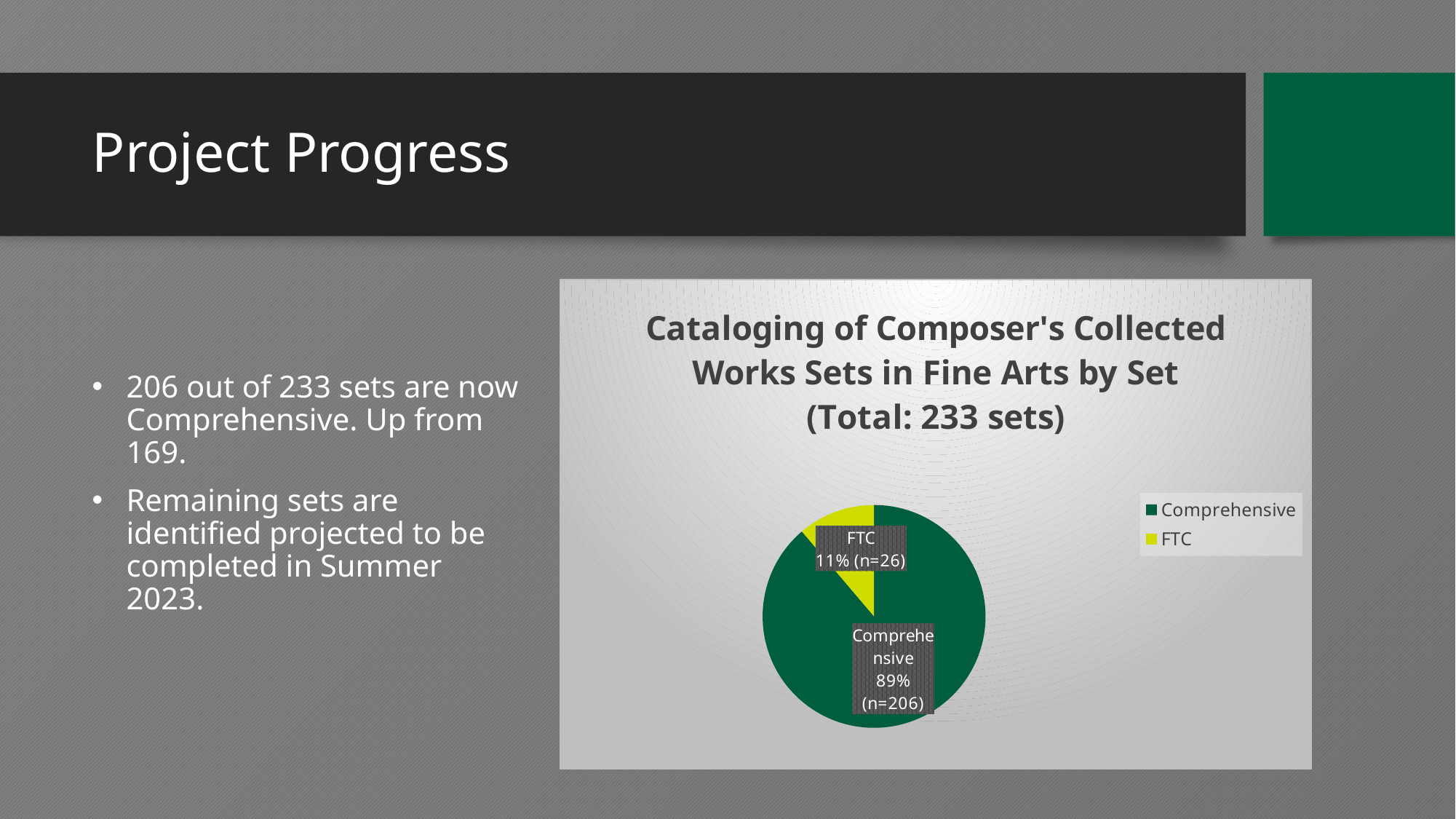
Which category has the smallest slice of the pie? FTC How many categories does the pie chart have? 2 What is the difference in number of sets between Comprehensive and FTC? 180 What colour is the FTC slice in the pie chart? Yellow-green How many sets are in the FTC category according to the data label? 26 What percentage of the pie does the FTC slice represent? 11% What is the total number of sets stated in the chart title? 233 sets Which category has the largest slice of the pie? Comprehensive What kind of chart is shown on the slide? Pie chart How many sets are in the Comprehensive category according to the data label? 206 Which is larger, the Comprehensive slice or the FTC slice? Comprehensive What percentage of the pie does the Comprehensive slice represent? 89%